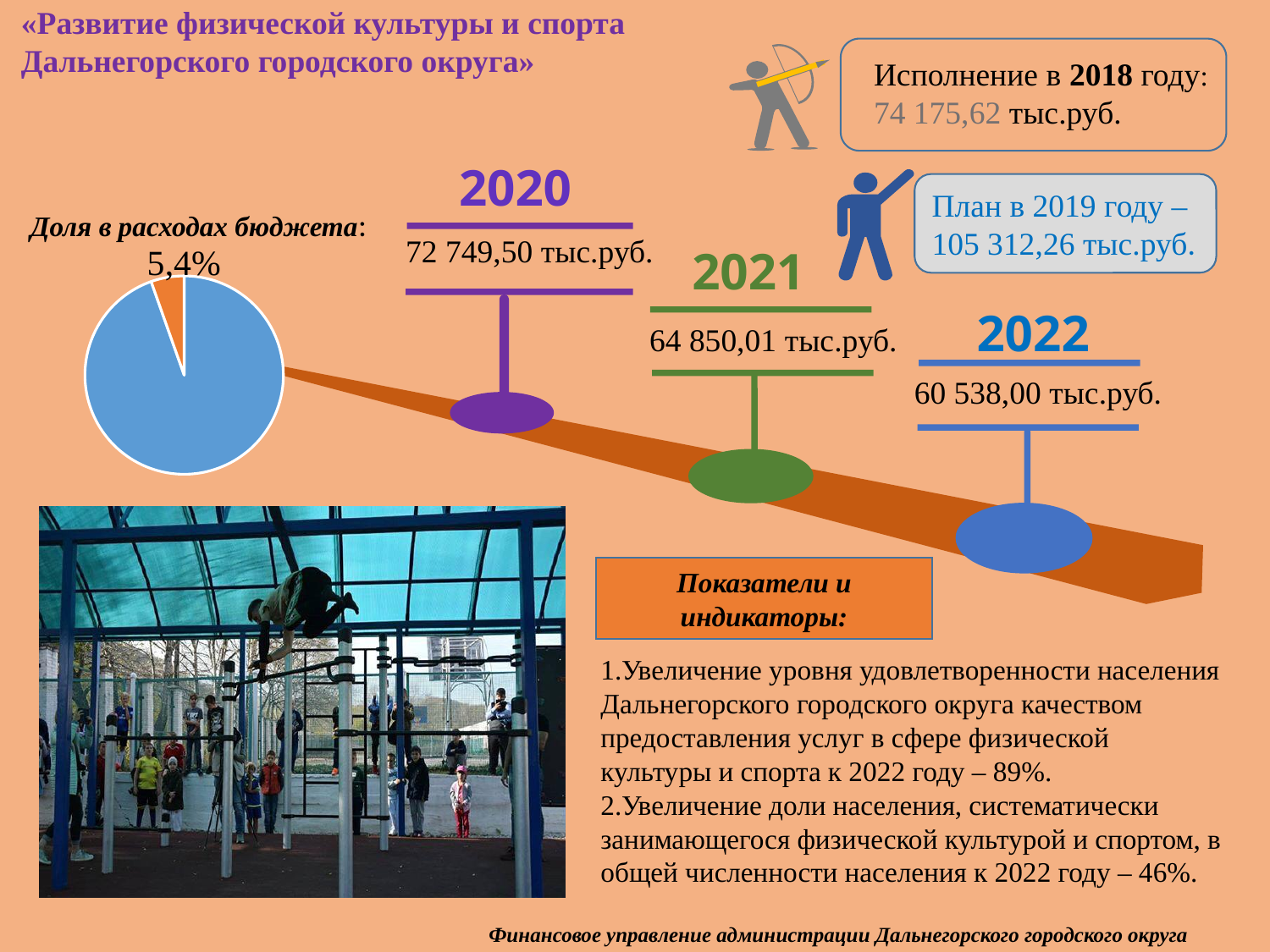
On the timeline diagram, what amount is shown for 2020? 72 749,50 тыс.руб. How many slices does the pie chart «Доля в расходах бюджета» have? 2 On the timeline diagram, which year has the lowest amount? 2022 What kind of chart is shown under the heading «Доля в расходах бюджета»? pie chart Is the labelled slice of the pie chart «Доля в расходах бюджета» greater or less than 10%? less On the timeline diagram, which year has the highest amount? 2020 In the pie chart «Доля в расходах бюджета», what colour is the slice labelled 5,4%? orange On the timeline diagram, do the amounts rise or fall from 2020 to 2022? fall In the pie chart «Доля в расходах бюджета», which slice is larger, the blue one or the orange one? the blue one On the timeline diagram, what amount is shown for 2022? 60 538,00 тыс.руб. In the pie chart «Доля в расходах бюджета», what value is printed on the small slice? 5,4% On the timeline diagram, what amount is shown for 2021? 64 850,01 тыс.руб.